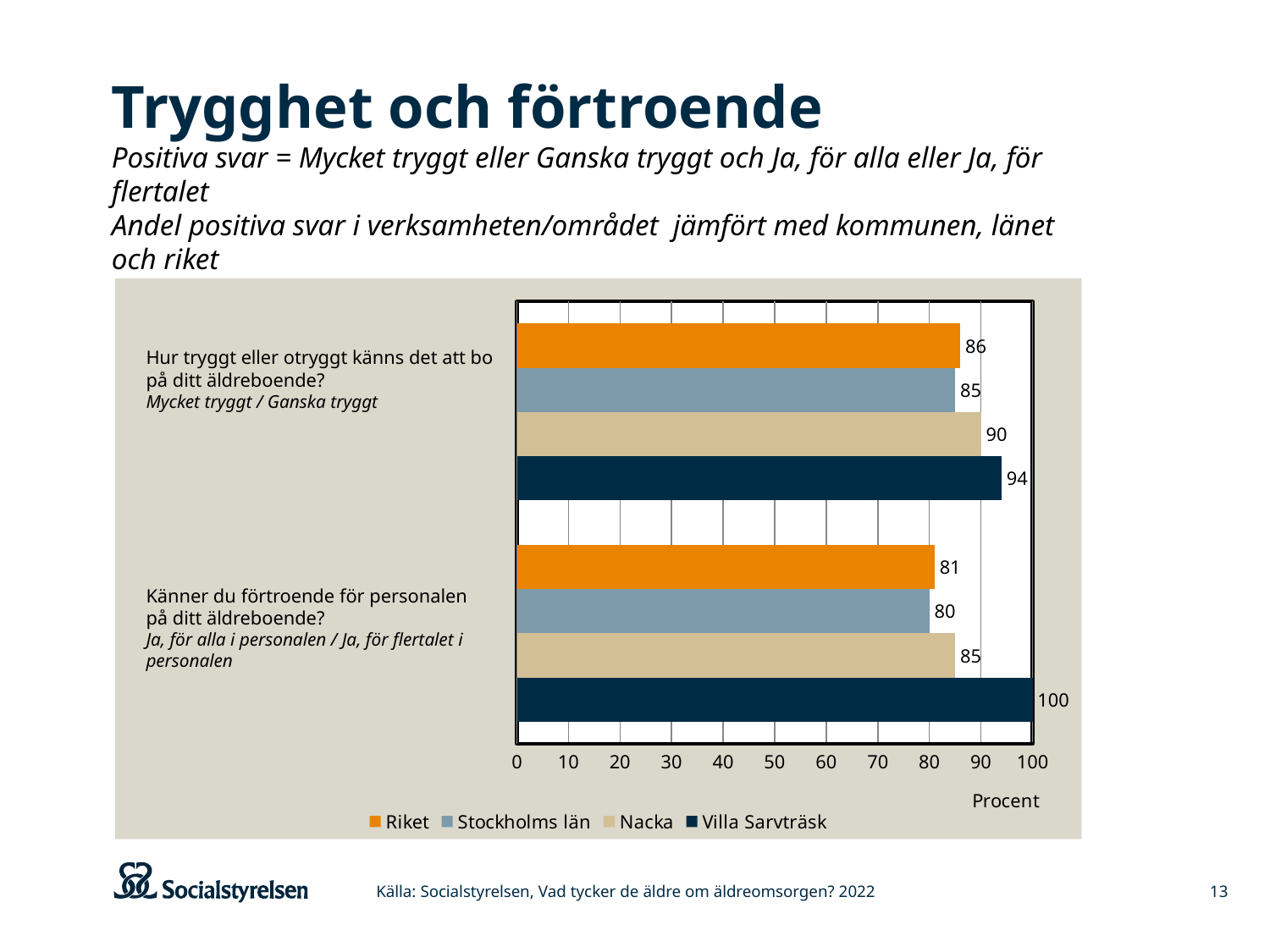
Which series has the lowest value on the question "Känner du förtroende för personalen på ditt äldreboende?"? Stockholms län How many series does the legend list? 4 What kind of chart is shown on the slide? Bar chart What value is shown for Riket on the question "Hur tryggt eller otryggt känns det att bo på ditt äldreboende?"? 86 Which is larger on the question "Hur tryggt eller otryggt känns det att bo på ditt äldreboende?": Nacka or Stockholms län? Nacka What value is shown for Stockholms län on the question "Hur tryggt eller otryggt känns det att bo på ditt äldreboende?"? 85 Which series has the highest value on the question "Hur tryggt eller otryggt känns det att bo på ditt äldreboende?"? Villa Sarvträsk What is the difference between Villa Sarvträsk and Riket on the question "Känner du förtroende för personalen på ditt äldreboende?"? 19 What is the label on the horizontal axis of the chart? Procent What value is shown for Nacka on the question "Känner du förtroende för personalen på ditt äldreboende?"? 85 How many questions (categories) are shown on the chart? 2 What value is shown for Villa Sarvträsk on the question "Känner du förtroende för personalen på ditt äldreboende?"? 100